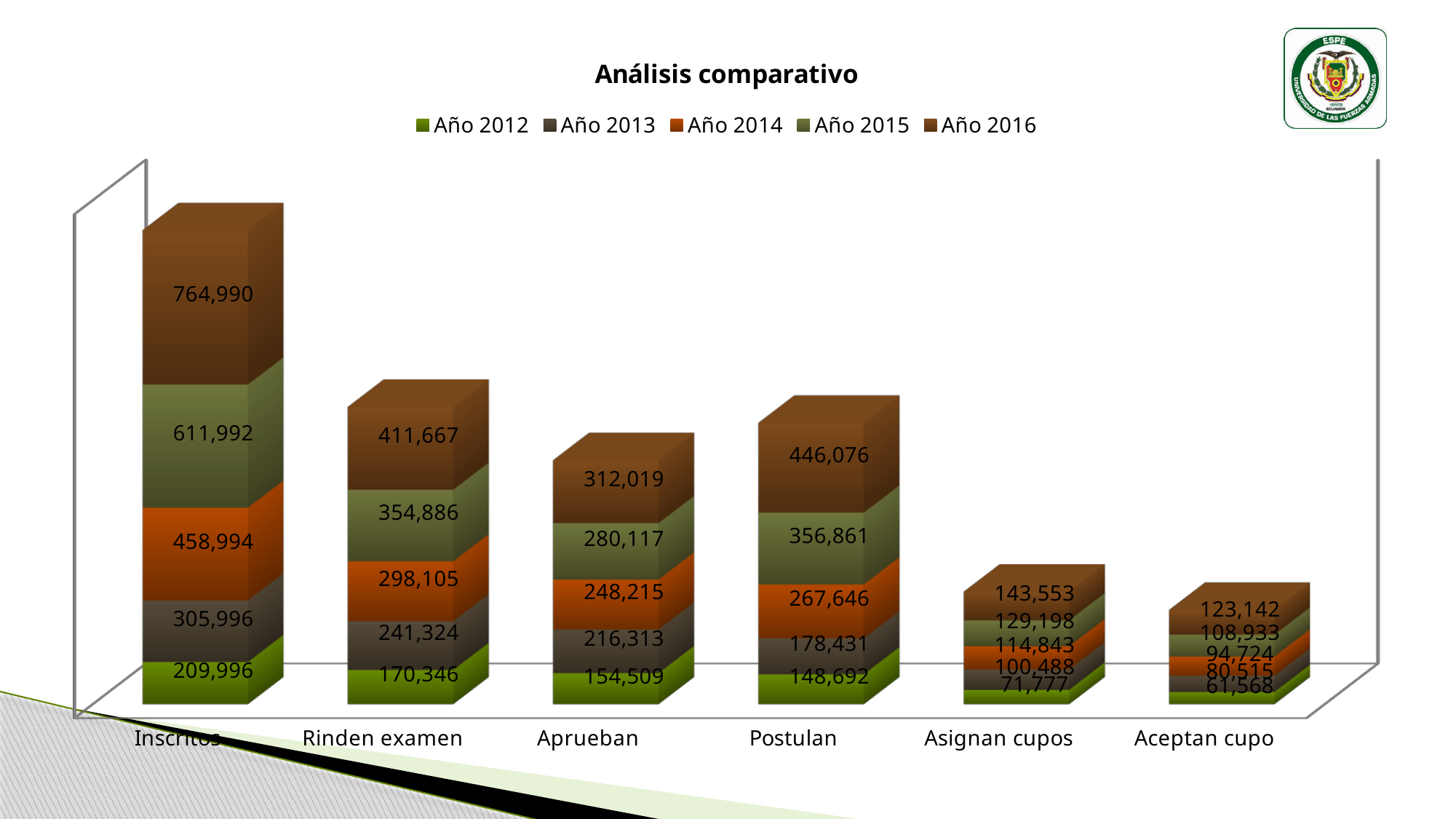
How many series does the legend list? 5 Which category has the shortest stacked bar? Aceptan cupo How many categories are shown on the x axis? 6 What is the value for Año 2016 in the Inscritos category? 764,990 What kind of chart is shown on the slide? Stacked bar chart What is the value for Año 2012 in the Aceptan cupo category? 61,568 What is the value for Año 2014 in the Postulan category? 267,646 What is the total of the stacked bar for Aceptan cupo? 468,882 Which is larger: the Año 2016 value for Aprueban or the Año 2016 value for Postulan? Postulan What is the value for Año 2015 in the Rinden examen category? 354,886 What is the difference between the Año 2016 and Año 2012 values in the Inscritos category? 554,994 Which category has the tallest stacked bar? Inscritos